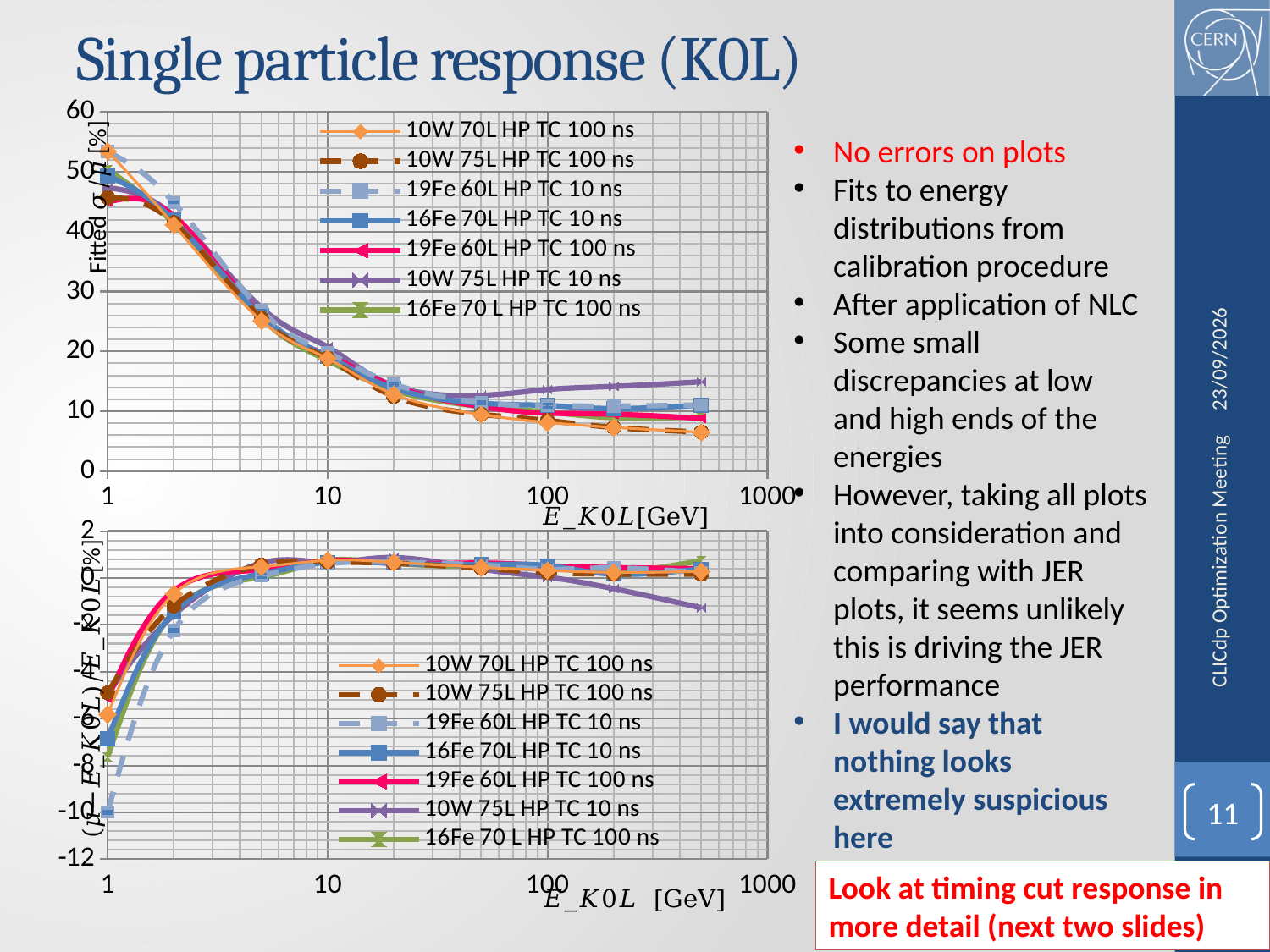
In the top chart, do the values of the series rise or fall as E_K0L increases from 1 to 100 GeV? fall In the bottom chart, is the value for 19Fe 60L HP TC 10 ns at 1 GeV greater or less than 0? less How many series does the legend of the top chart list? 7 How many series does the legend of the bottom chart list? 7 In the top chart, is the value for 10W 75L HP TC 10 ns at its rightmost point greater or less than 10? greater In the top chart, which series has the highest value at the rightmost energy point? 10W 75L HP TC 10 ns What kind of chart is the top chart on the slide? line chart What is the x-axis label of the top chart? E_K0L [GeV] In the top chart, is the value for 10W 70L HP TC 100 ns at 1 GeV greater or less than 40? greater How many charts are shown on the slide? 2 In the bottom chart, which series has the lowest value at the rightmost energy point? 10W 75L HP TC 10 ns